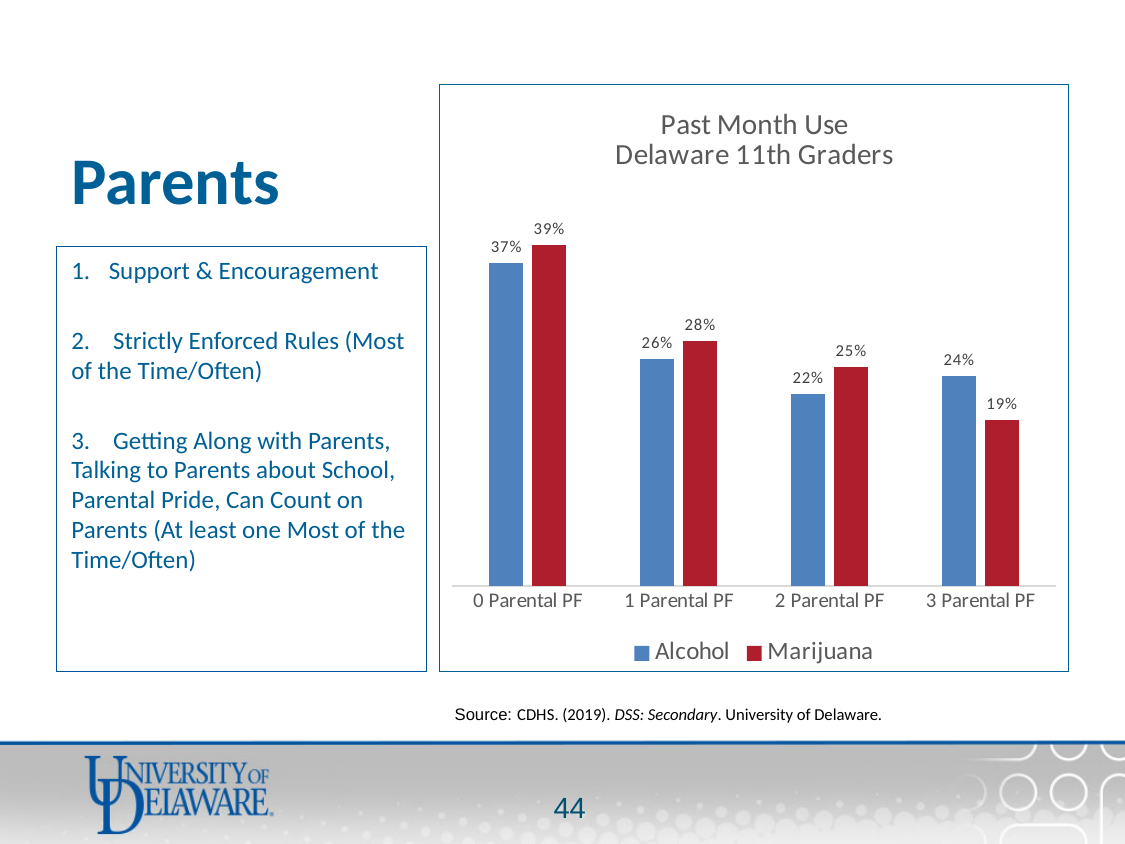
What is the Marijuana value for 1 Parental PF? 28% For 3 Parental PF, which is larger, Alcohol or Marijuana? Alcohol How many series does the legend list? 2 How many categories are shown on the x axis? 4 What kind of chart is shown? Bar chart Do the Marijuana values rise or fall from 0 Parental PF to 3 Parental PF? Fall Which category has the lowest Alcohol value? 2 Parental PF What is the Marijuana value for 3 Parental PF? 19% What is the title of the chart? Past Month Use Delaware 11th Graders What is the difference between the Marijuana and Alcohol values for 2 Parental PF? 3% What is the Alcohol value for 0 Parental PF? 37% Which category has the highest Marijuana value? 0 Parental PF